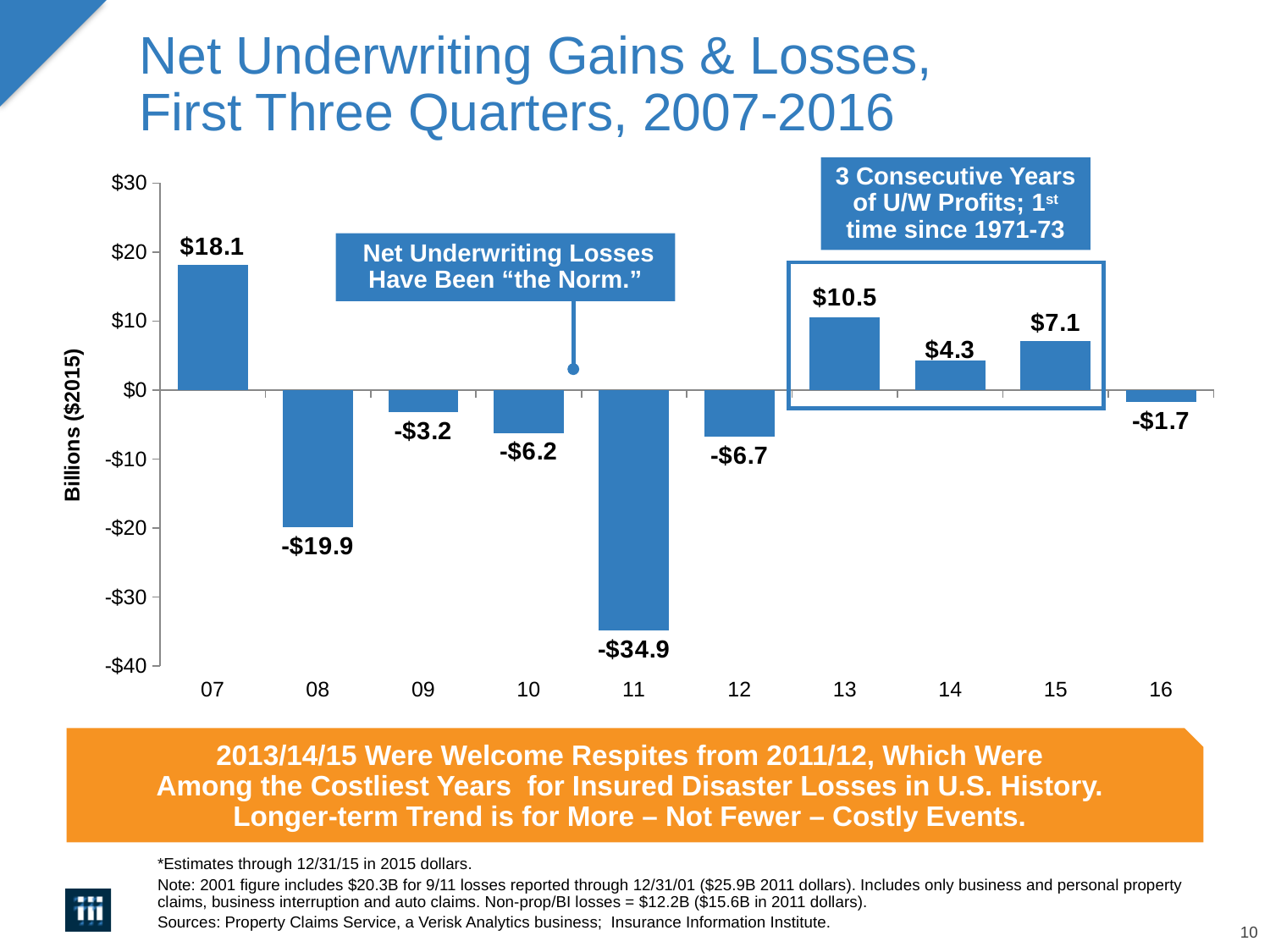
What is the net underwriting gain or loss for 2007? $18.1 What is the label on the y axis? Billions ($2015) What kind of chart is this? bar chart What is the value shown for 2014? $4.3 Which year has the larger value, 2010 or 2012? 10 What is the difference between the values for 2013 and 2015? $3.4 Which year has the highest value? 07 What is the value shown for 2016? -$1.7 What is the value shown for 2011? -$34.9 Which year has the lowest value? 11 How many years are shown on the x axis? 10